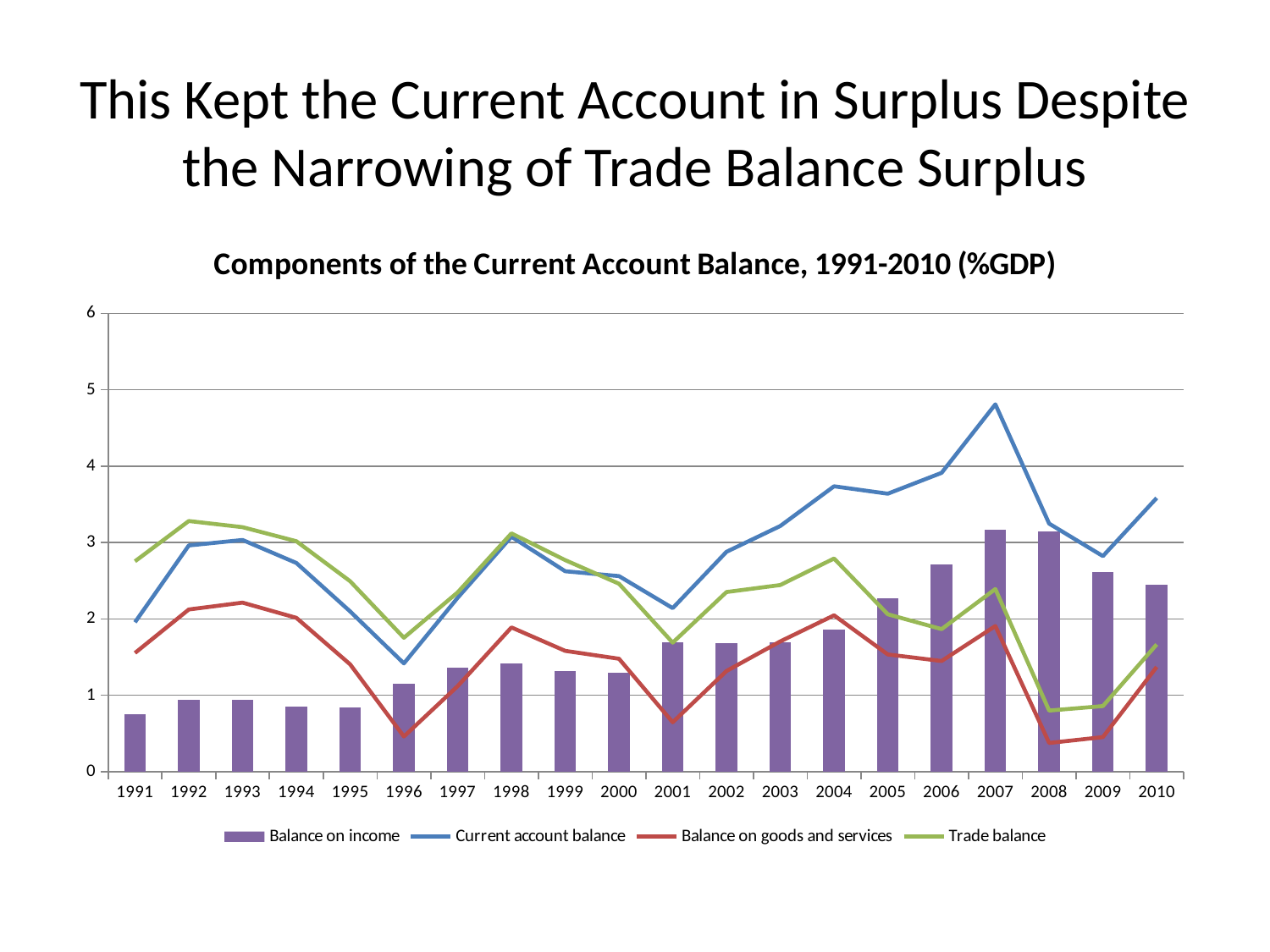
In 2010, which is larger: the Current account balance or the Trade balance? Current account balance How many series does the legend list? 4 Which series is drawn in green? Trade balance What is the title of the chart? Components of the Current Account Balance, 1991-2010 (%GDP) In which year is the Current account balance lowest? 1996 In which year is the Balance on income bar lowest? 1991 Is the Trade balance in 2008 greater or less than 1? less In which year is the Current account balance highest? 2007 What kind of chart is this? Combined bar and line chart Is the Balance on income in 2006 greater or less than 2? greater Is the Current account balance in 2007 greater or less than 4? greater How many years are shown on the x axis? 20